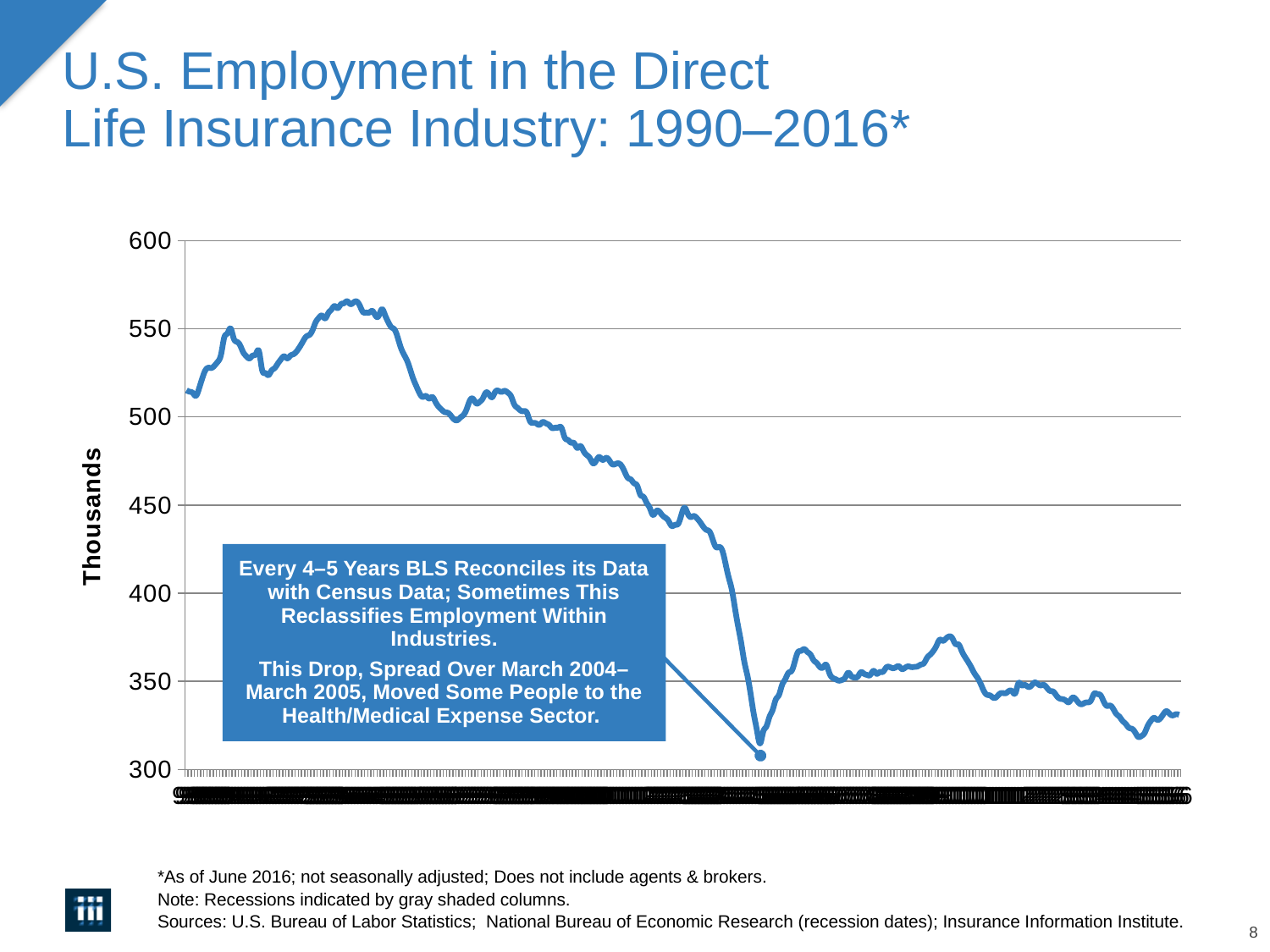
What is the title of the chart on the slide? U.S. Employment in the Direct Life Insurance Industry: 1990–2016* Is the value at the left-hand start of the line (1990) greater or less than 500? greater What kind of chart is shown on the slide? line chart Is the value at the right-hand end of the line (2016) greater or less than 350? less Overall, does the line rise or fall from the left of the chart to the right? fall Is the lowest point of the line greater or less than 350? less What is the label on the vertical axis of the chart? Thousands Which is larger: the value at the start of the line (1990) or the value at the end of the line (2016)? the value at the start (1990) What is the highest tick value shown on the vertical axis? 600 How many lines (data series) are plotted on the chart? 1